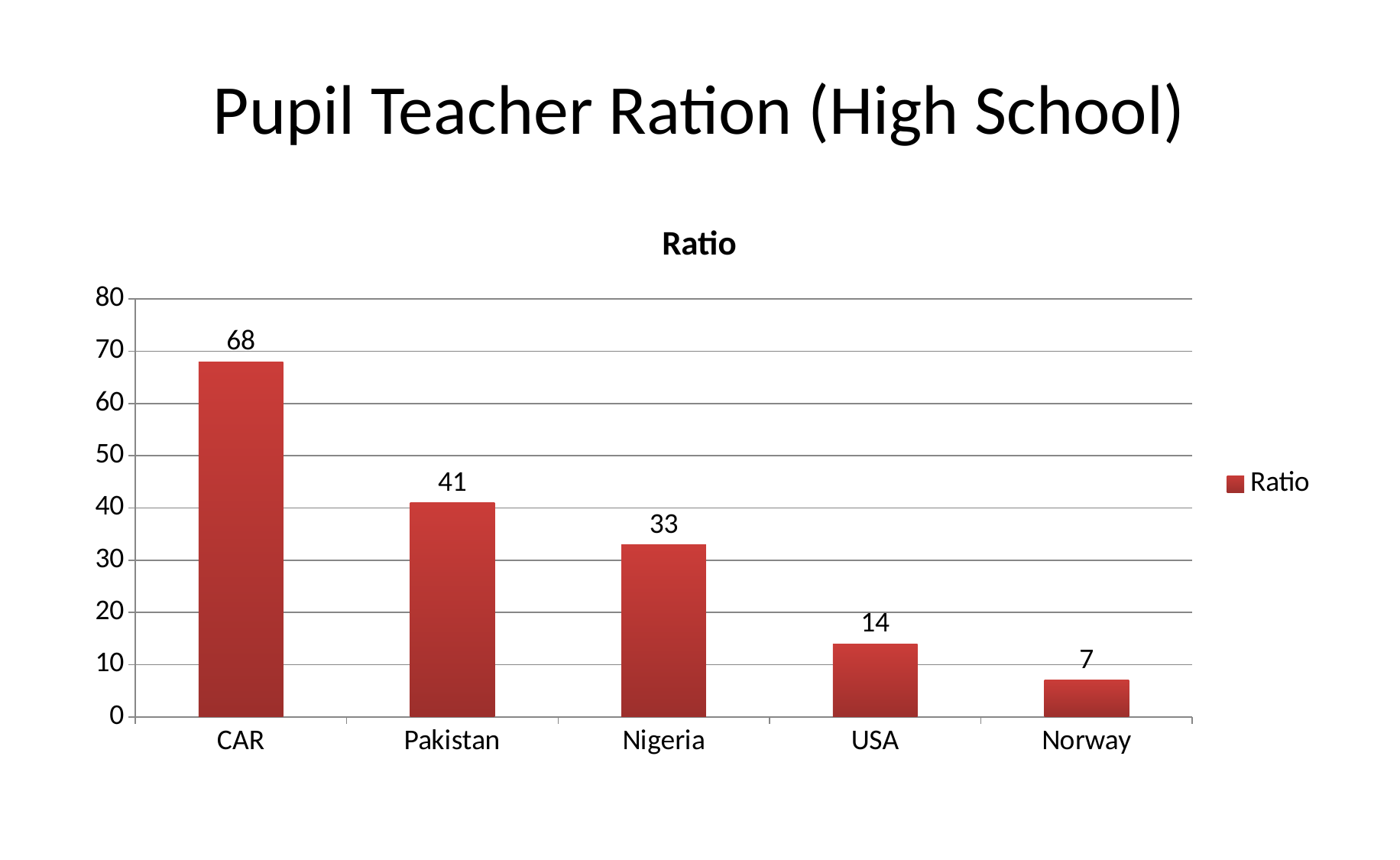
What is the difference between the ratio for Pakistan and the ratio for Nigeria? 8 Which country has the highest ratio? CAR Which country has the lowest ratio? Norway Is the value for Pakistan greater or less than 40? greater What is the ratio value for Pakistan? 41 How many countries are shown on the chart? 5 What is the ratio value for CAR? 68 What is the title of the chart? Ratio What is the difference between the ratio for CAR and the ratio for USA? 54 What is the ratio value for Norway? 7 Which has a larger ratio, Nigeria or USA? Nigeria What kind of chart is shown on the slide? bar chart